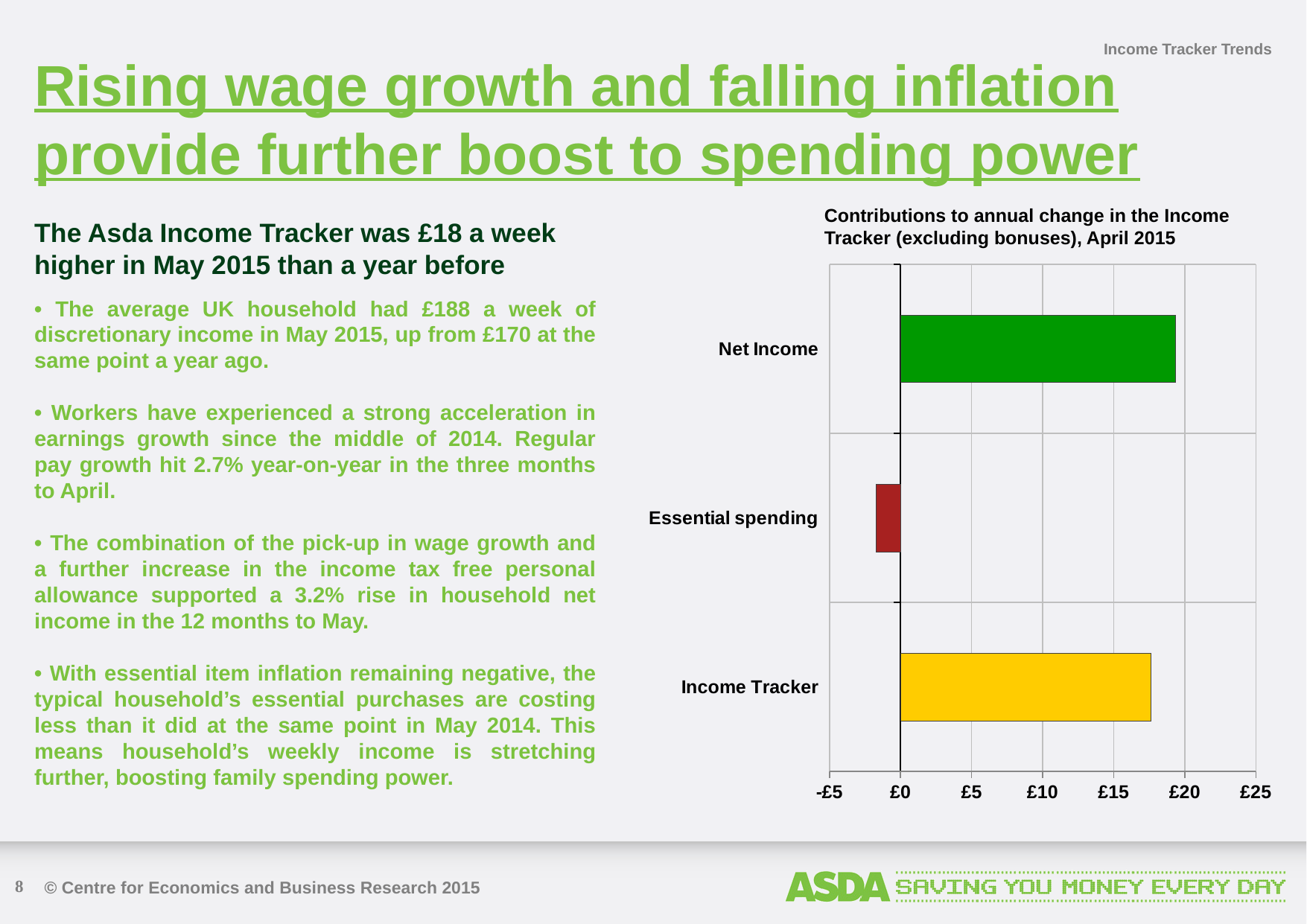
What kind of chart is shown on the slide? bar chart What colour is the Income Tracker bar in the chart? yellow How many categories are plotted in the chart? 3 Which is larger, the value for Net Income or the value for Income Tracker? Net Income Is the value for Essential spending greater or less than £0? less Which category has the highest value in the chart? Net Income Is the value for Income Tracker greater or less than £20? less What is the title of the chart? Contributions to annual change in the Income Tracker (excluding bonuses), April 2015 Is the value for Income Tracker greater or less than £15? greater Which category has the lowest value in the chart? Essential spending Which category is the only one with a negative contribution in the chart? Essential spending